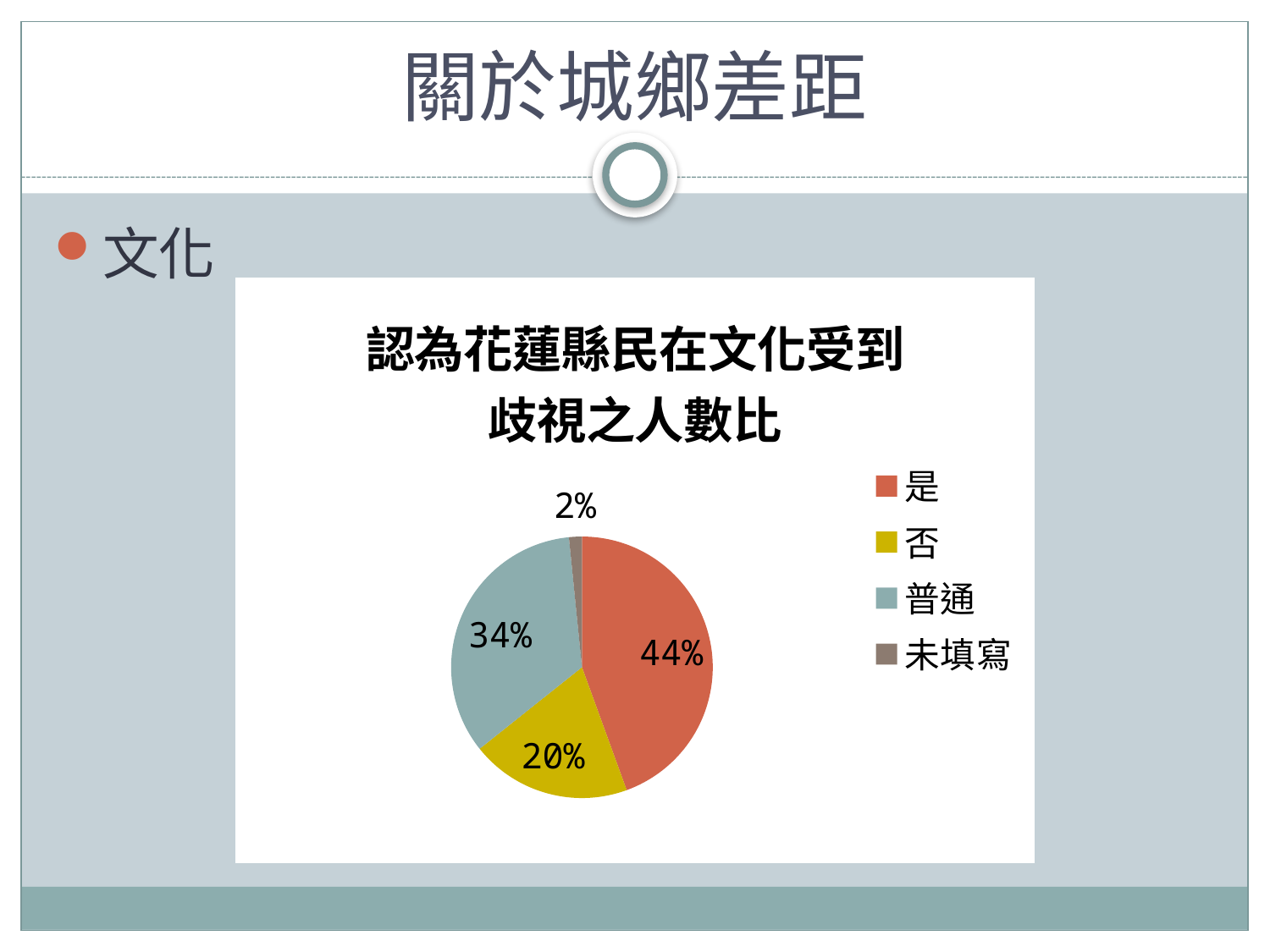
How many categories does the pie chart have? 4 What percentage of the pie is the 普通 slice? 34% Which slice is larger, 否 or 普通? 普通 What percentage of the pie is the 否 slice? 20% What kind of chart is shown on the slide? pie chart What is the title of the chart? 認為花蓮縣民在文化受到歧視之人數比 Which category has the smallest share of the pie? 未填寫 What is the difference in percentage points between the 是 slice and the 普通 slice? 10% What percentage of the pie is the 未填寫 slice? 2% What percentage of the pie is the 是 slice? 44% Which category has the largest share of the pie? 是 What colour is the 是 slice in the pie chart? red